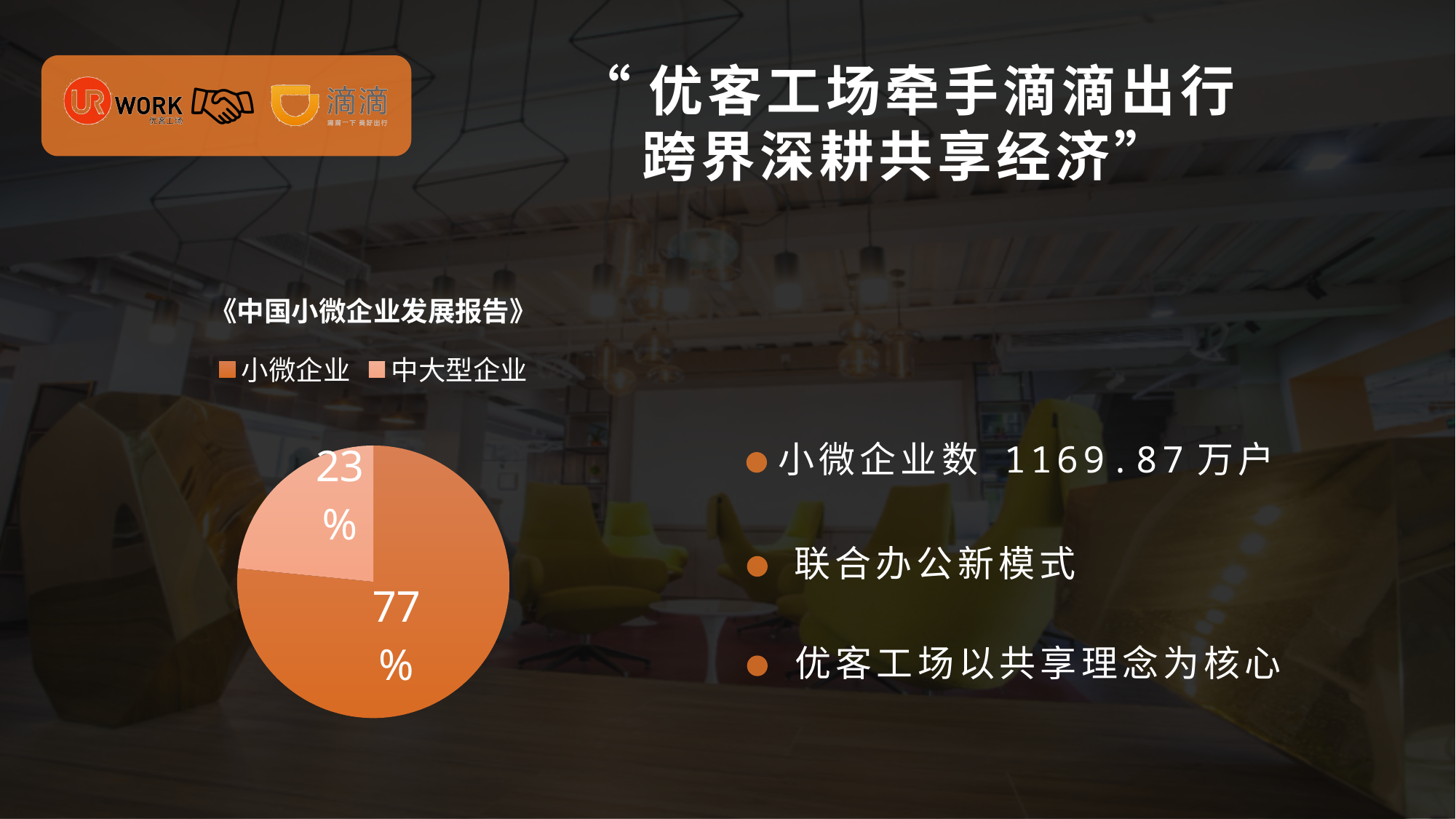
Which category has the smallest slice of the pie? 中大型企业 What is the difference in percentage points between the 小微企业 slice and the 中大型企业 slice? 54 How many slices does the pie chart have? 2 What kind of chart is shown on the slide? pie chart What share of the pie does 小微企业 take? 77% What is the title of the chart? 《中国小微企业发展报告》 Which slice is larger, 小微企业 or 中大型企业? 小微企业 Is the share for 中大型企业 greater or less than 50%? less How many entries does the chart legend list? 2 Which legend entry is shown in the lighter orange colour? 中大型企业 What share of the pie does 中大型企业 take? 23% Which category has the largest slice of the pie? 小微企业